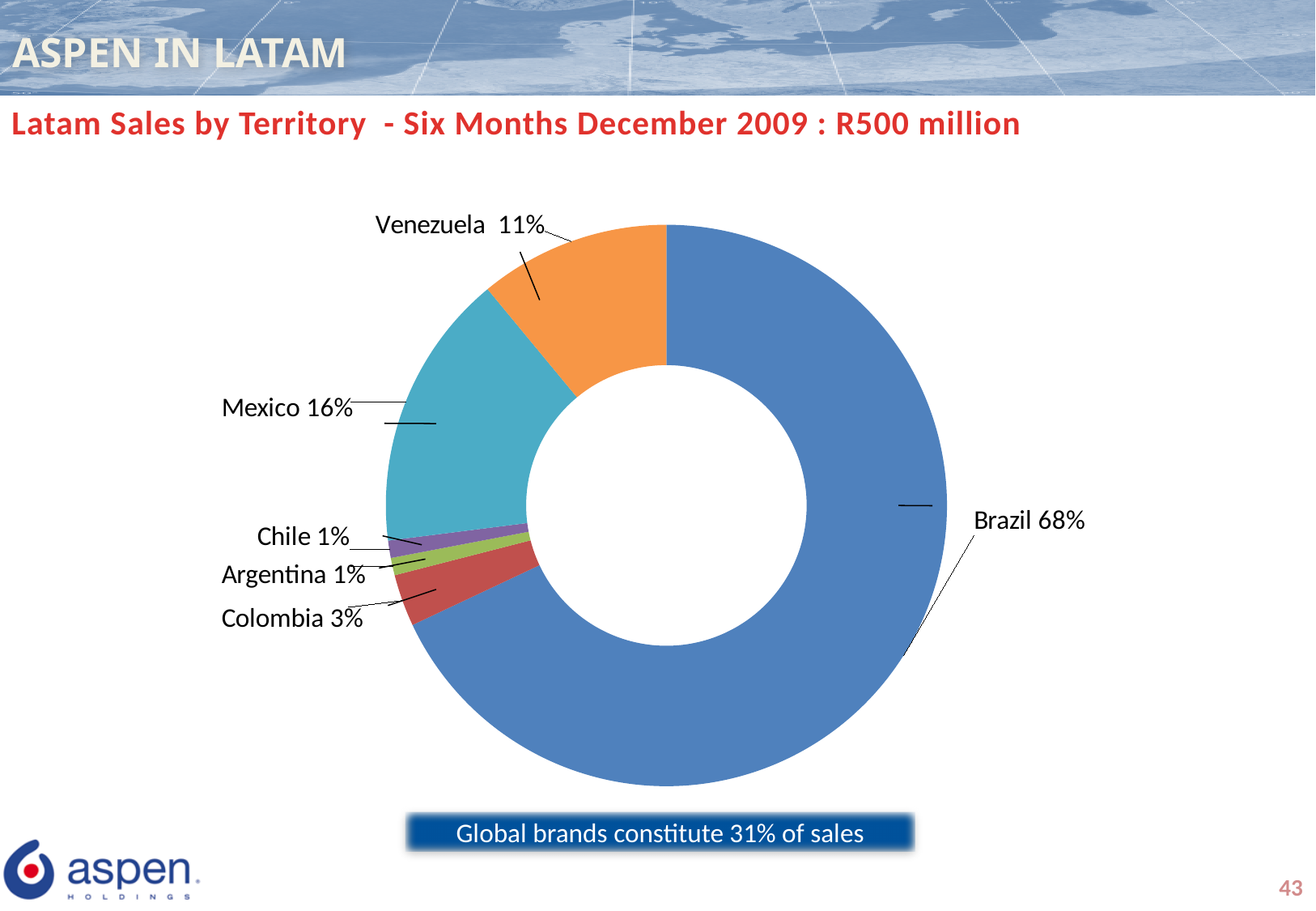
What is the difference in percentage points between Mexico's and Venezuela's shares? 5 percentage points What type of chart is used to show Latam sales by territory? Doughnut (pie) chart What share of Latam sales does Venezuela account for? 11% How many territories are shown in the chart? 6 What share of Latam sales does Mexico account for? 16% What is the difference in percentage points between Brazil's and Mexico's shares? 52 percentage points Which has a larger share of Latam sales, Venezuela or Colombia? Venezuela Which territory has the largest share of Latam sales? Brazil What share of Latam sales does Colombia account for? 3% What total sales figure is given in the chart title for the six months to December 2009? R500 million Which territory has the largest share after Brazil? Mexico What share of Latam sales does Brazil account for? 68%